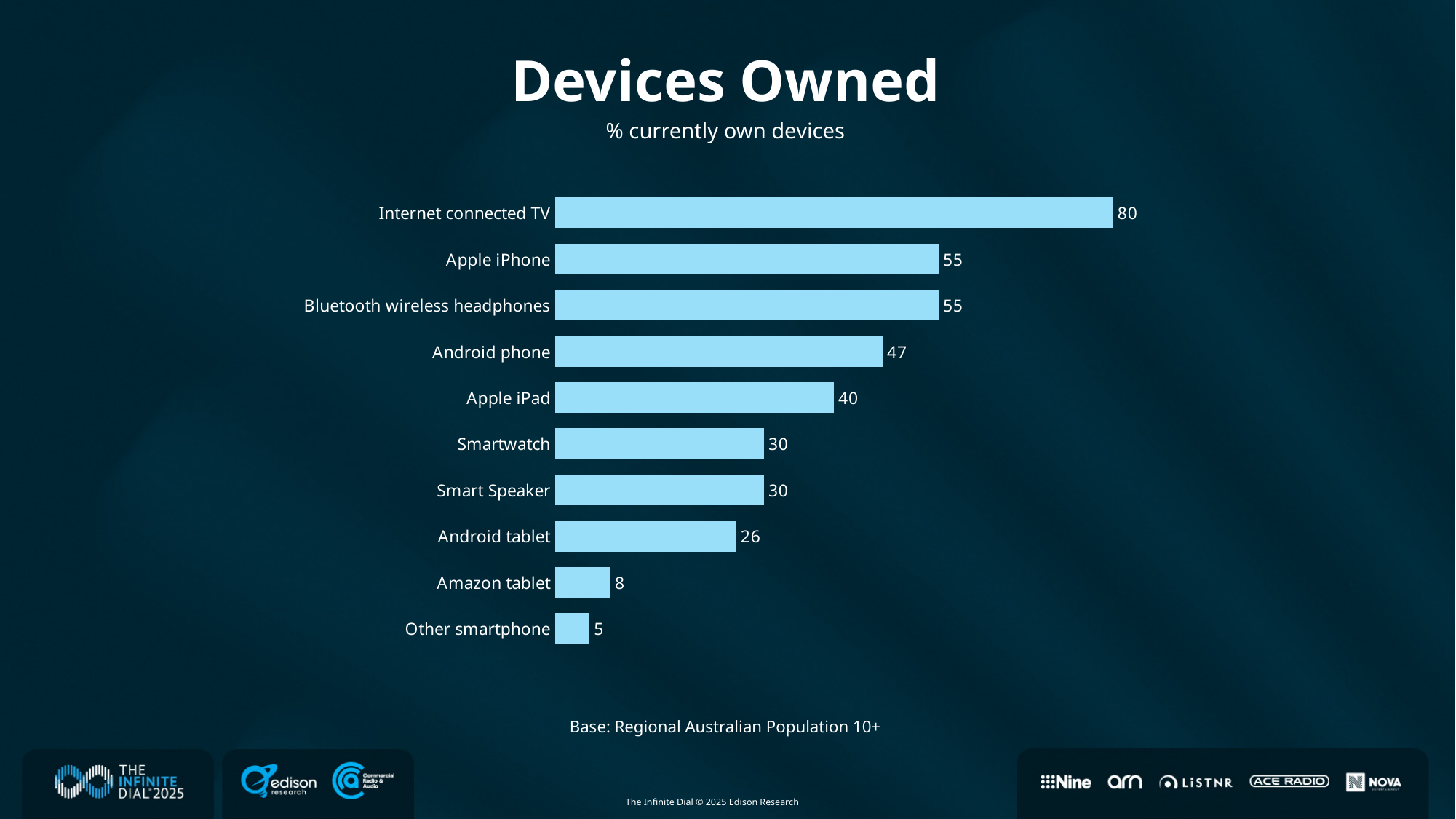
What is the value for Apple iPad? 40 What is the difference between the values for Android tablet and Amazon tablet? 18 What is the difference between the values for Internet connected TV and Apple iPhone? 25 What is the value for Android phone? 47 Which is larger, the value for Android phone or the value for Apple iPad? Android phone What is the title of the chart? Devices Owned What is the value for Amazon tablet? 8 What is the value for Internet connected TV? 80 What kind of chart is shown on the slide? Bar chart Which device has the lowest value? Other smartphone How many devices are shown in the chart? 10 Which device has the highest value? Internet connected TV